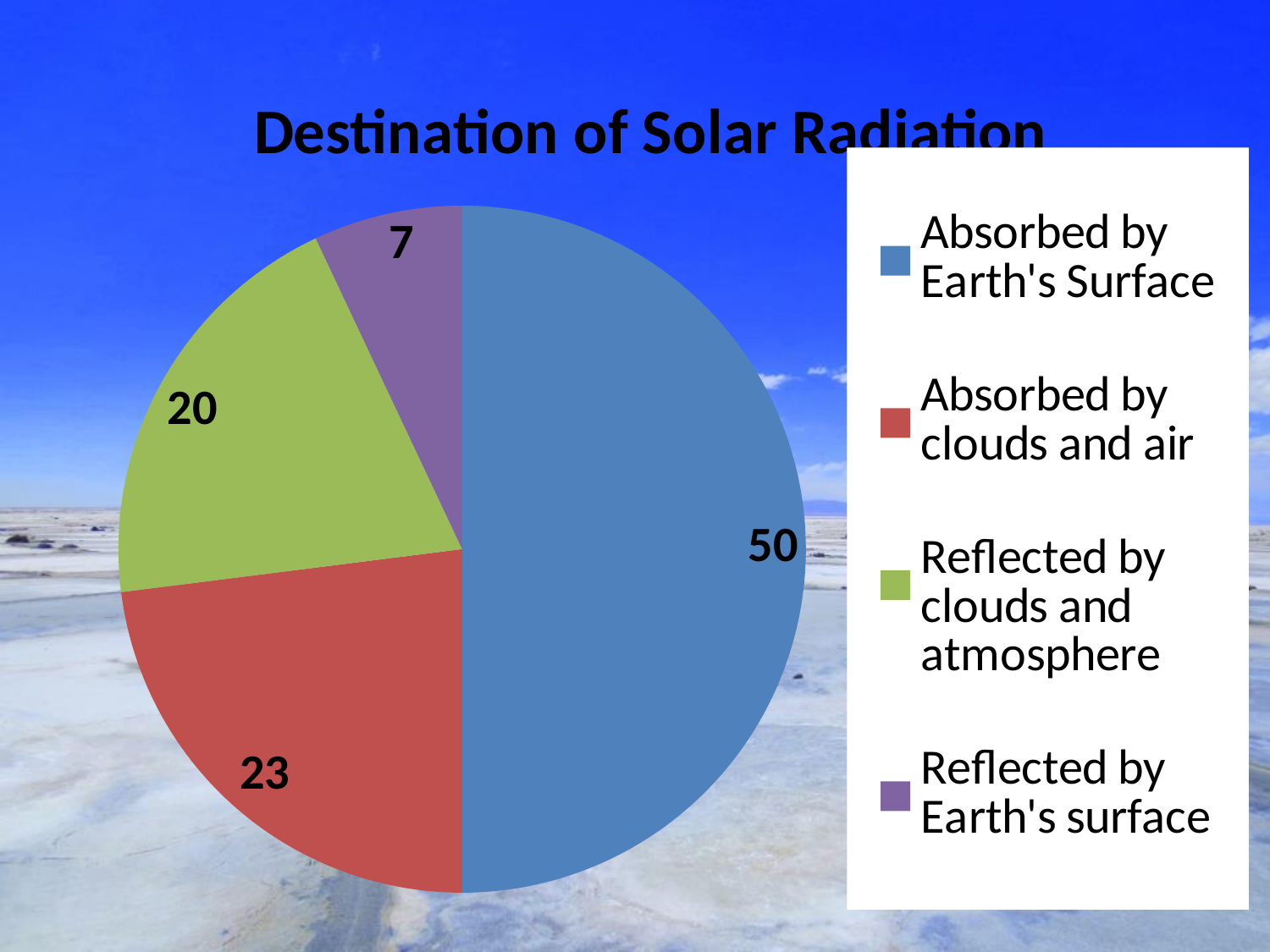
What is the value for Absorbed by clouds and air? 23 What type of chart is shown on the slide? Pie chart What is the value for Absorbed by Earth's Surface? 50 What is the title of the chart? Destination of Solar Radiation What is the value for Reflected by clouds and atmosphere? 20 How many categories does the legend list? 4 What is the difference between the values for Absorbed by Earth's Surface and Absorbed by clouds and air? 27 Which is larger, Absorbed by clouds and air or Reflected by clouds and atmosphere? Absorbed by clouds and air Which category has the largest slice of the pie? Absorbed by Earth's Surface Which category has the smallest slice of the pie? Reflected by Earth's surface What is the value for Reflected by Earth's surface? 7 What share of the pie does Absorbed by Earth's Surface represent? 50%